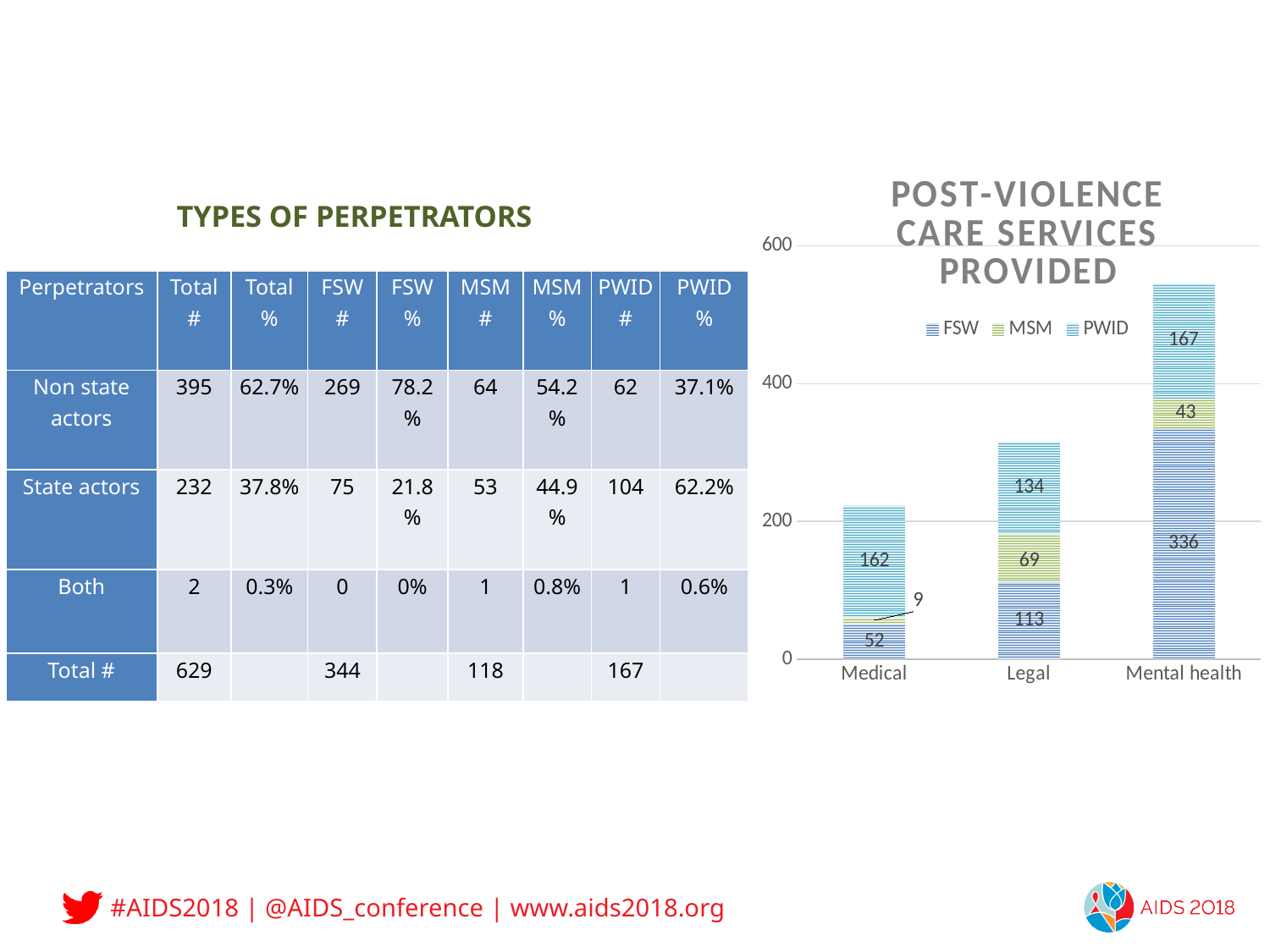
What is the FSW value for Mental health? 336 How many categories are shown on the x axis of the chart? 3 What is the total of the stacked bar for Legal? 316 Is the total of the Mental health bar greater or less than 400? greater Which category has the lowest MSM value? Medical Which category has the highest FSW value? Mental health What is the title of the chart? POST-VIOLENCE CARE SERVICES PROVIDED What type of chart is shown on the slide? Stacked bar chart How many series does the chart legend list? 3 What is the MSM value for Medical? 9 What is the PWID value for Legal? 134 What is the difference between the PWID values for Mental health and Medical? 5